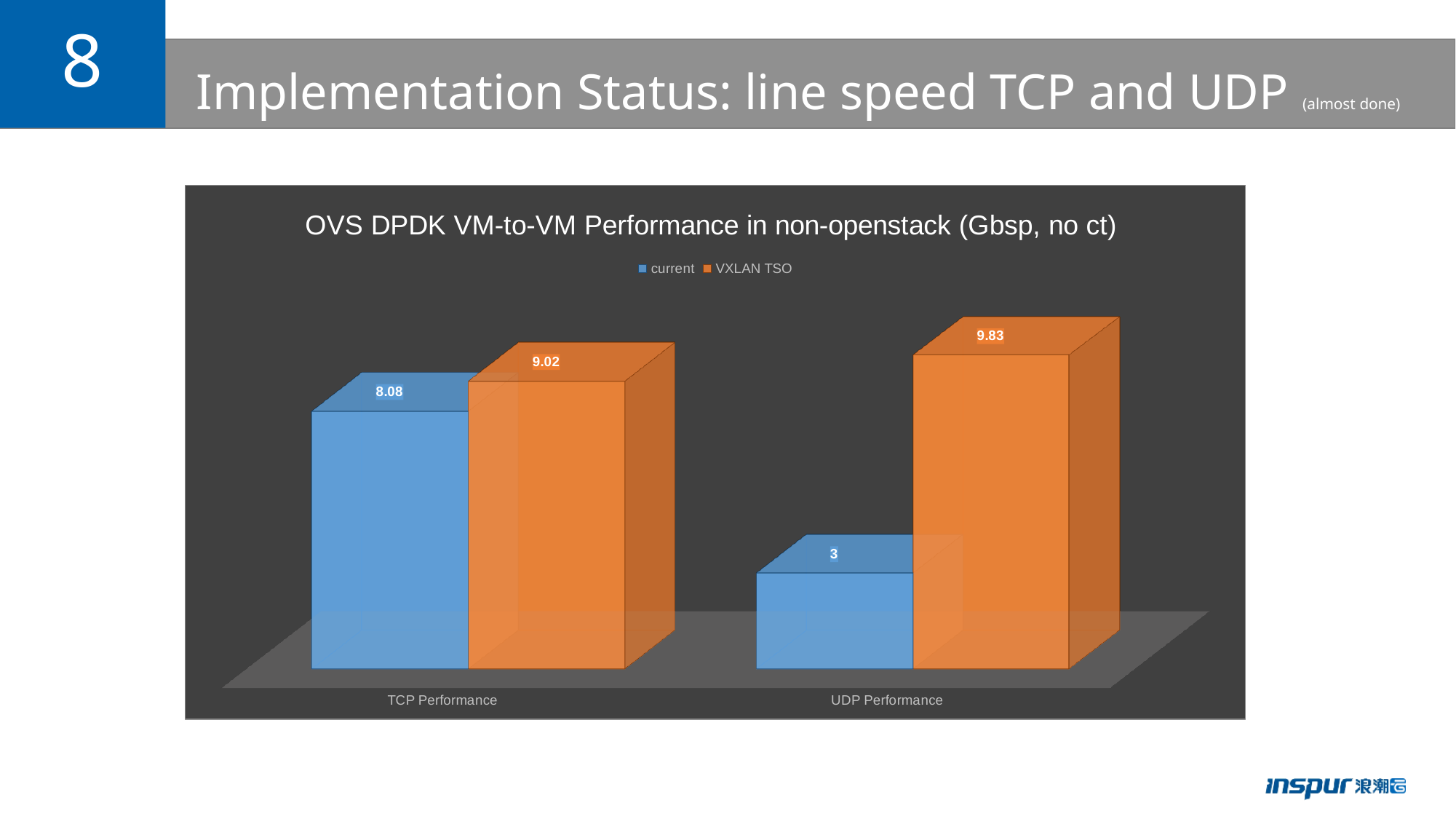
Which category has the lowest 'current' value? UDP Performance Which is larger: the 'current' value for TCP Performance or the 'current' value for UDP Performance? TCP Performance What is the value for 'current' in TCP Performance? 8.08 What is the difference between the 'VXLAN TSO' and 'current' values for TCP Performance? 0.94 How many series does the legend list? 2 What is the value for 'current' in UDP Performance? 3 What is the difference between the 'VXLAN TSO' and 'current' values for UDP Performance? 6.83 What is the value for 'VXLAN TSO' in TCP Performance? 9.02 Which category has the highest 'VXLAN TSO' value? UDP Performance How many categories are shown on the x axis? 2 What is the value for 'VXLAN TSO' in UDP Performance? 9.83 What kind of chart is shown on the slide? Bar chart